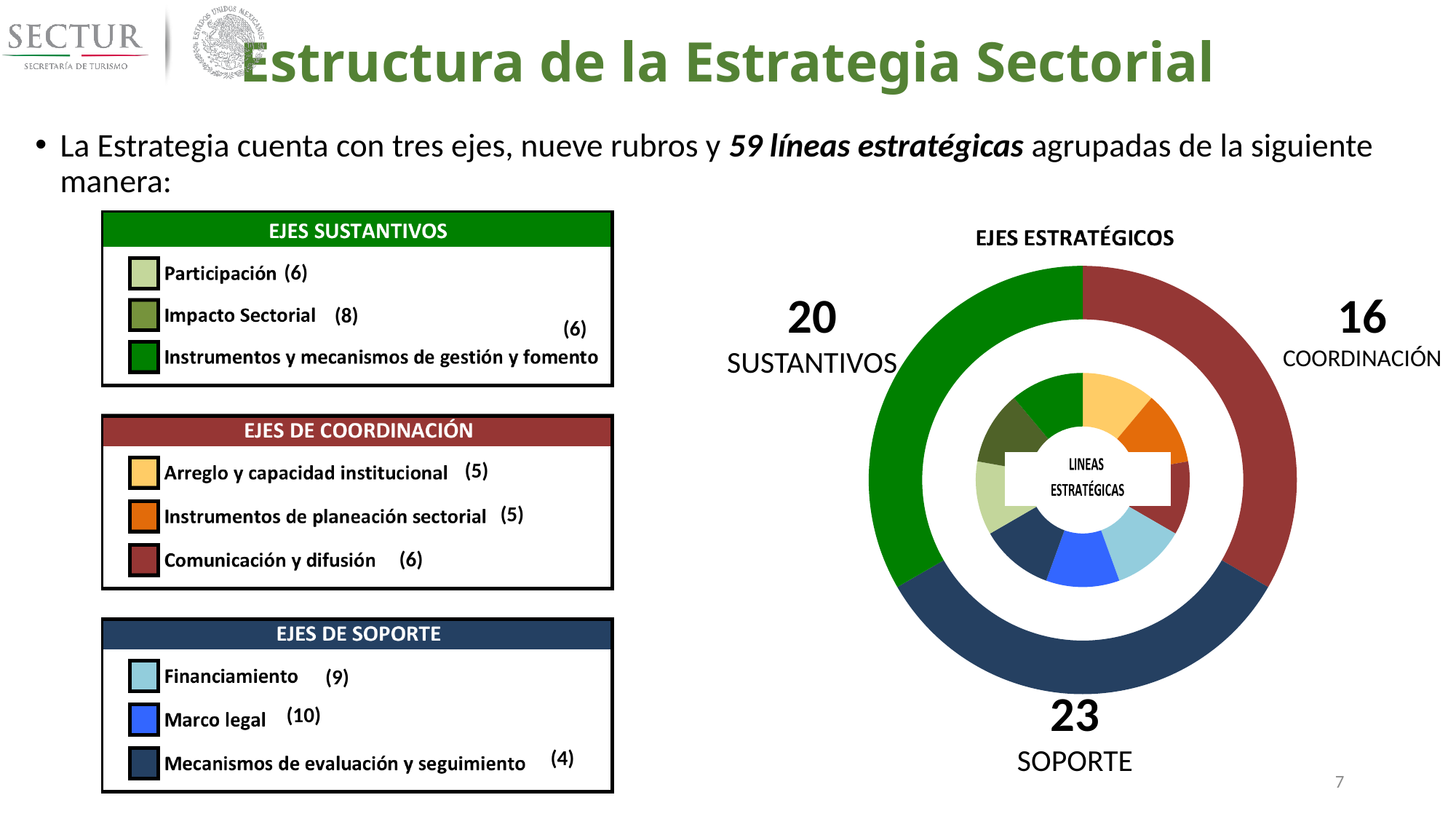
In the EJES ESTRATÉGICOS chart, which is larger, SUSTANTIVOS or COORDINACIÓN? SUSTANTIVOS In the EJES ESTRATÉGICOS chart, which of the three ejes has the largest number of líneas estratégicas? SOPORTE How many segments does the outer ring of the EJES ESTRATÉGICOS chart have? 3 In the EJES ESTRATÉGICOS chart, how many líneas estratégicas are labelled for COORDINACIÓN? 16 What kind of chart is shown under the title EJES ESTRATÉGICOS? Doughnut chart In the EJES ESTRATÉGICOS chart, how many líneas estratégicas are labelled for SOPORTE? 23 What text appears in the centre of the EJES ESTRATÉGICOS doughnut chart? LINEAS ESTRATÉGICAS In the EJES ESTRATÉGICOS chart, what is the difference between the SOPORTE value and the COORDINACIÓN value? 7 How many segments does the inner ring of the EJES ESTRATÉGICOS chart have? 9 In the EJES ESTRATÉGICOS chart, how many líneas estratégicas are labelled for SUSTANTIVOS? 20 In the EJES ESTRATÉGICOS chart, what is the total of the three outer-ring values (SUSTANTIVOS, COORDINACIÓN and SOPORTE)? 59 In the EJES ESTRATÉGICOS chart, which of the three ejes has the smallest number of líneas estratégicas? COORDINACIÓN